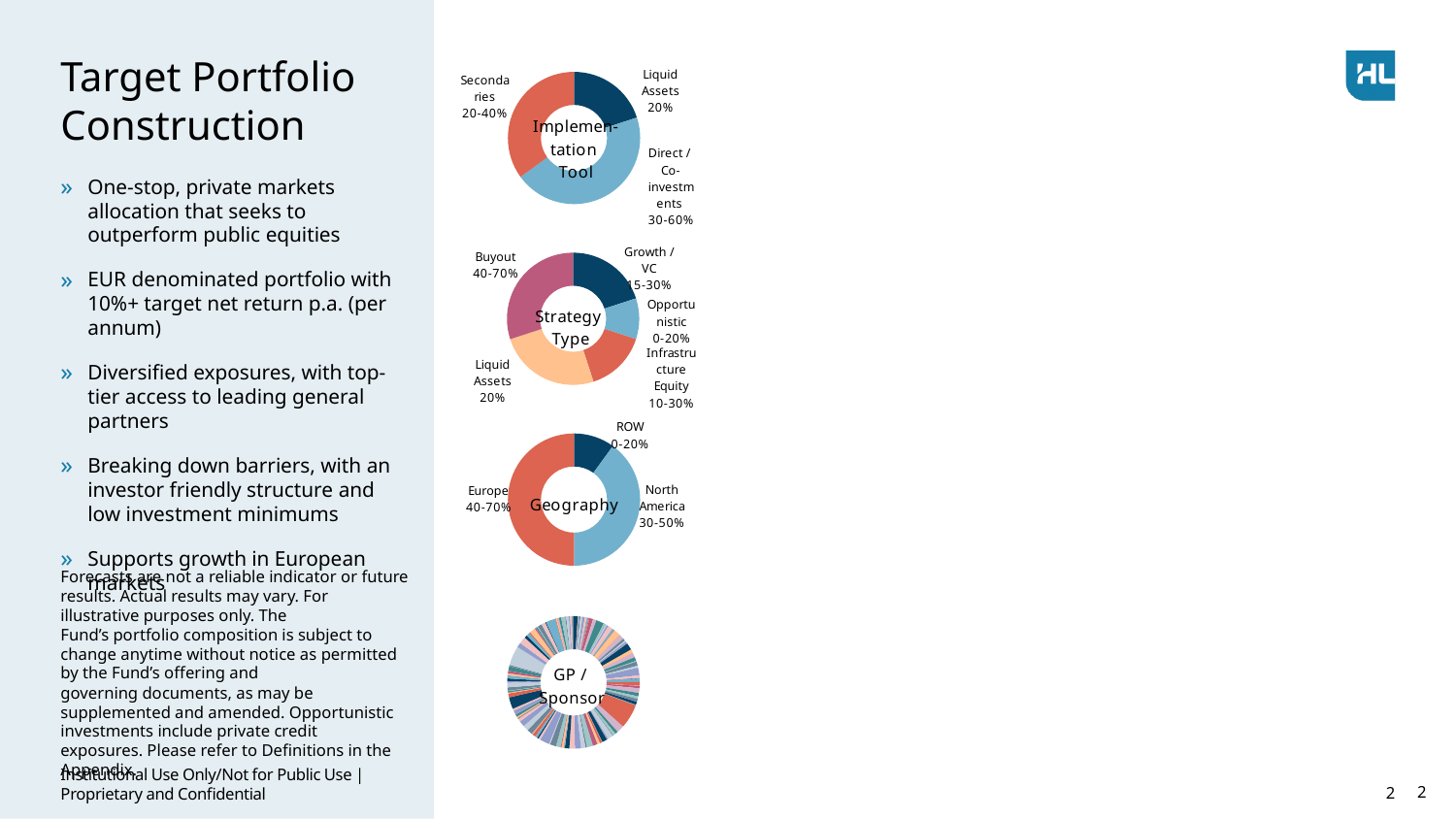
In the Strategy Type chart, what is the allocation range shown for Infrastructure Equity? 10-30% In the Strategy Type chart, what is the allocation range shown for Opportunistic? 0-20% In the Implementation Tool chart, what is the allocation range shown for Direct / Co-investments? 30-60% In the Strategy Type chart, what is the allocation range shown for Buyout? 40-70% What kind of chart is the Geography chart? Donut chart How many categories are shown in the Strategy Type chart? 5 In the Geography chart, which category has the smallest slice? ROW In the Implementation Tool chart, what is the allocation range shown for Secondaries? 20-40% How many donut charts are shown on the slide? 4 In the Geography chart, what is the allocation range shown for North America? 30-50% In the Geography chart, which category has the largest slice? Europe In the Implementation Tool chart, what is the allocation shown for Liquid Assets? 20%